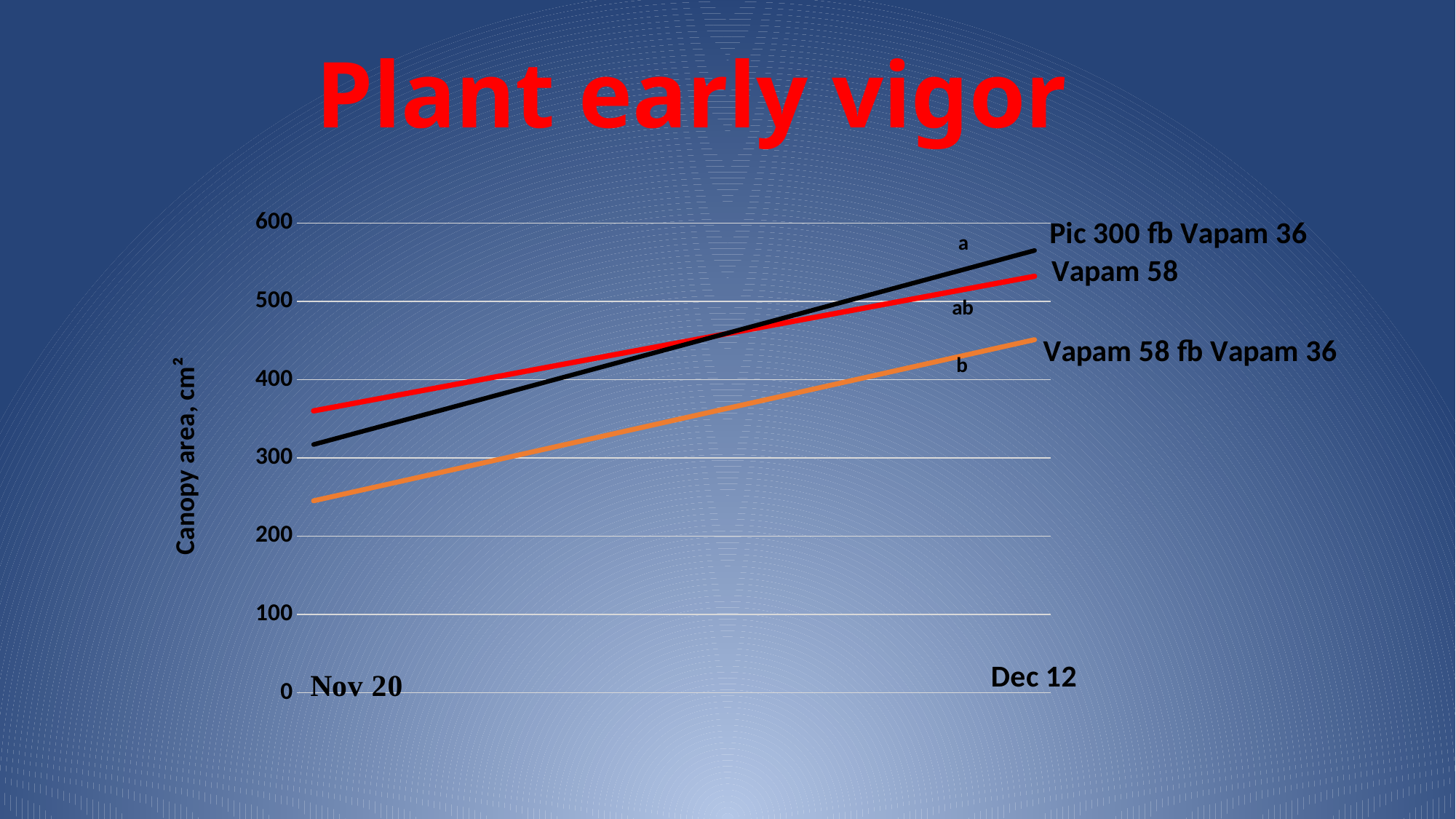
Is the canopy area for Vapam 58 fb Vapam 36 on Nov 20 greater or less than 300? less What is the label of the y axis? Canopy area, cm² What kind of chart is shown on the slide? line chart How many series (treatments) are plotted on the chart? 3 Which treatment has the highest canopy area on Nov 20? Vapam 58 Which treatment has the highest canopy area on Dec 12? Pic 300 fb Vapam 36 Which treatment has the lowest canopy area on Dec 12? Vapam 58 fb Vapam 36 Do the canopy area values for Vapam 58 fb Vapam 36 rise or fall from Nov 20 to Dec 12? rise Is the canopy area for Pic 300 fb Vapam 36 on Dec 12 greater or less than 500? greater How many dates are shown on the x axis? 2 On Nov 20, which is larger: the canopy area for Vapam 58 or for Pic 300 fb Vapam 36? Vapam 58 What is the title of the chart on the slide? Plant early vigor